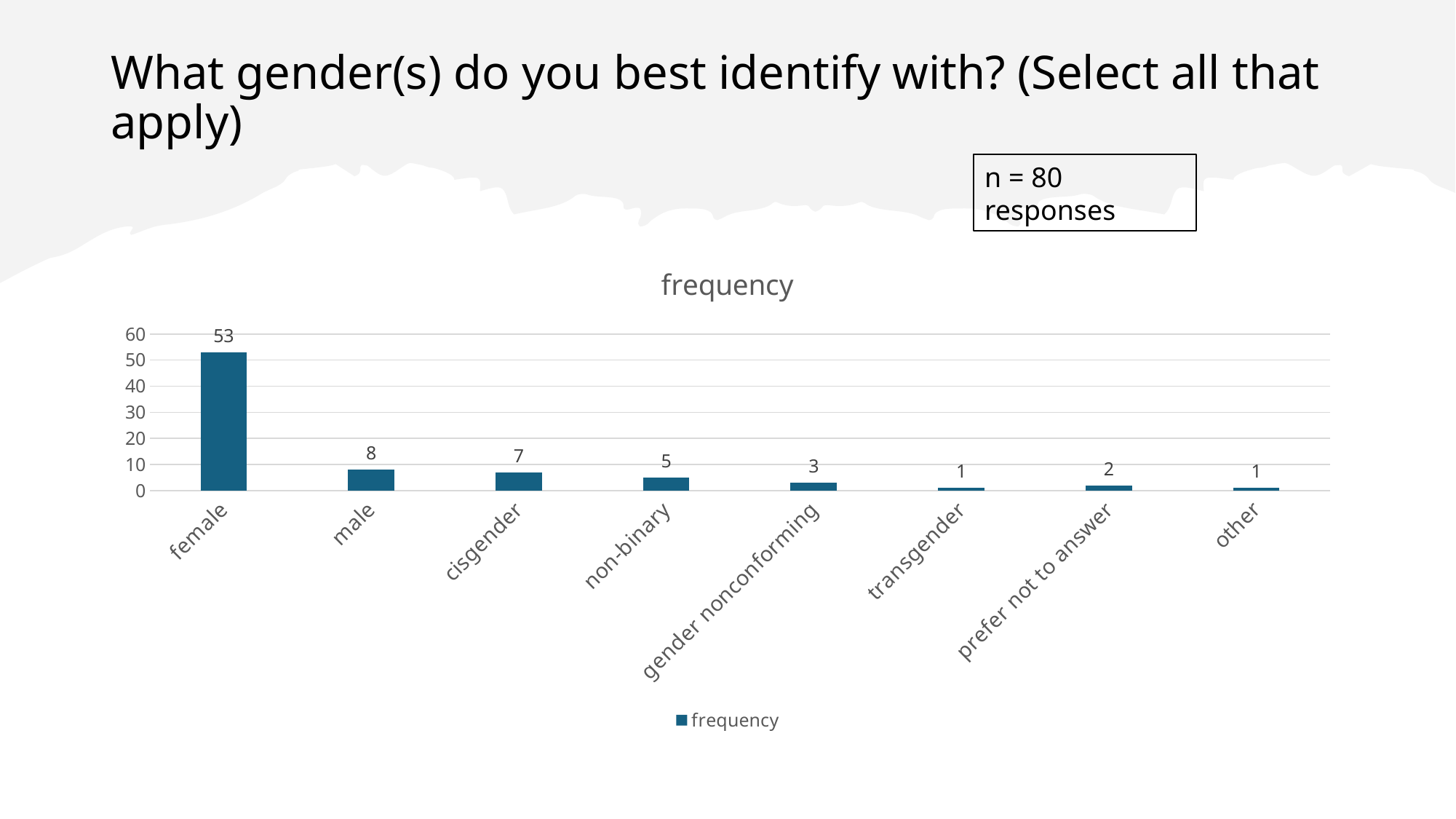
What is the frequency for gender nonconforming? 3 What is the frequency for prefer not to answer? 2 Which category has the highest frequency? female What is the difference between the frequency for cisgender and the frequency for non-binary? 2 What is the frequency for female? 53 What is the difference between the frequency for female and the frequency for male? 45 What kind of chart is shown on the slide? bar chart Is the frequency for female greater or less than 50? greater Which has a higher frequency, male or cisgender? male What is the frequency for male? 8 How many categories are shown on the x axis? 8 What is the title of the chart? frequency